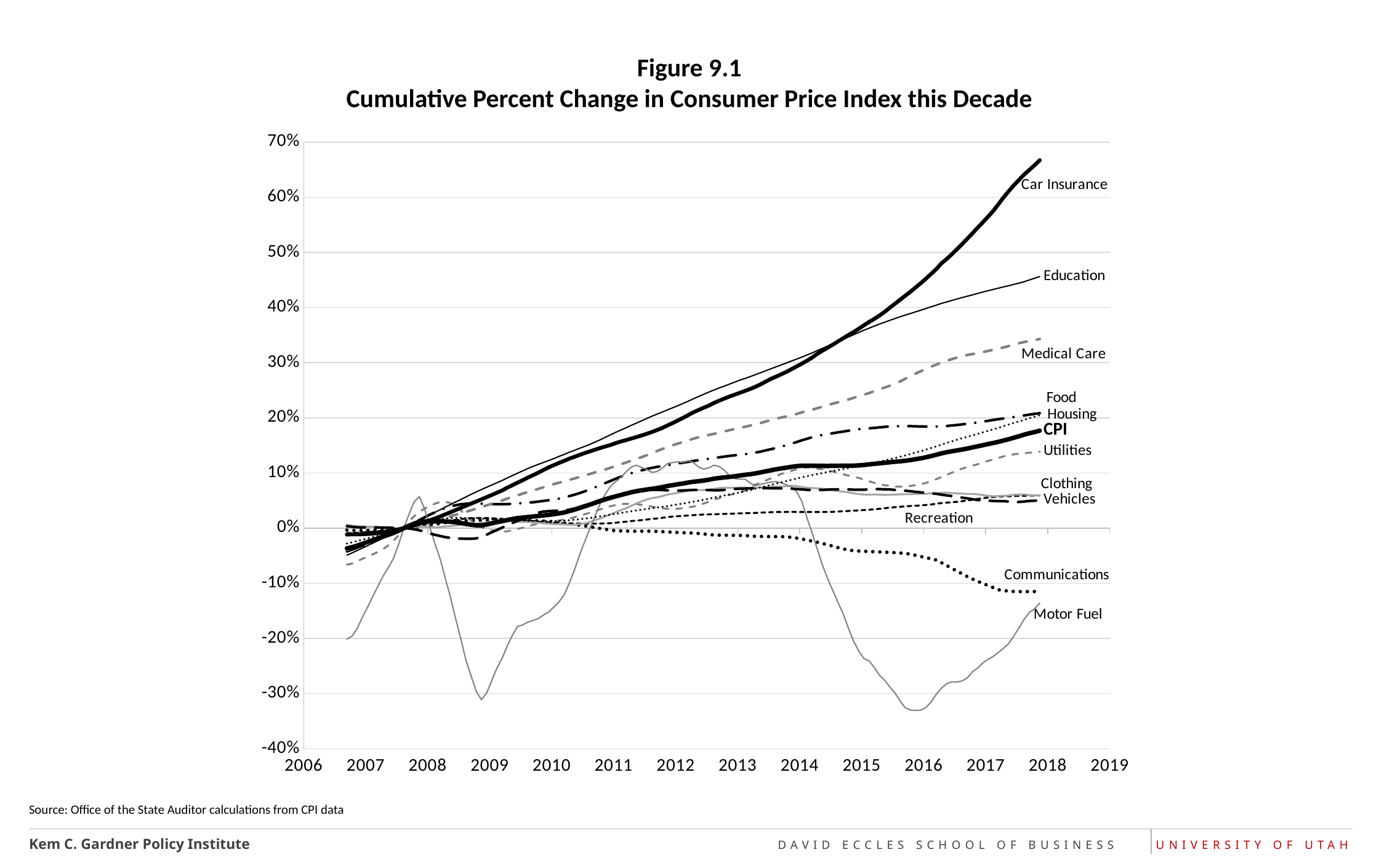
At the end of the chart (2018), which is higher: Medical Care or Food? Medical Care What is the title of the chart? Figure 9.1 Cumulative Percent Change in Consumer Price Index this Decade Is the value for CPI at the end of the chart (2018) greater or less than 20%? less Is the value for Education at the end of the chart (2018) greater or less than 40%? greater Is the value for Communications at the end of the chart (2018) greater or less than -10%? less What kind of chart is shown on the slide? line chart Which series reaches the lowest value anywhere on the chart? Motor Fuel How many labeled series are plotted on the chart? 12 Which series reaches the highest value at the right end of the chart (2018)? Car Insurance Does the Communications line generally rise or fall from 2011 to 2018? fall